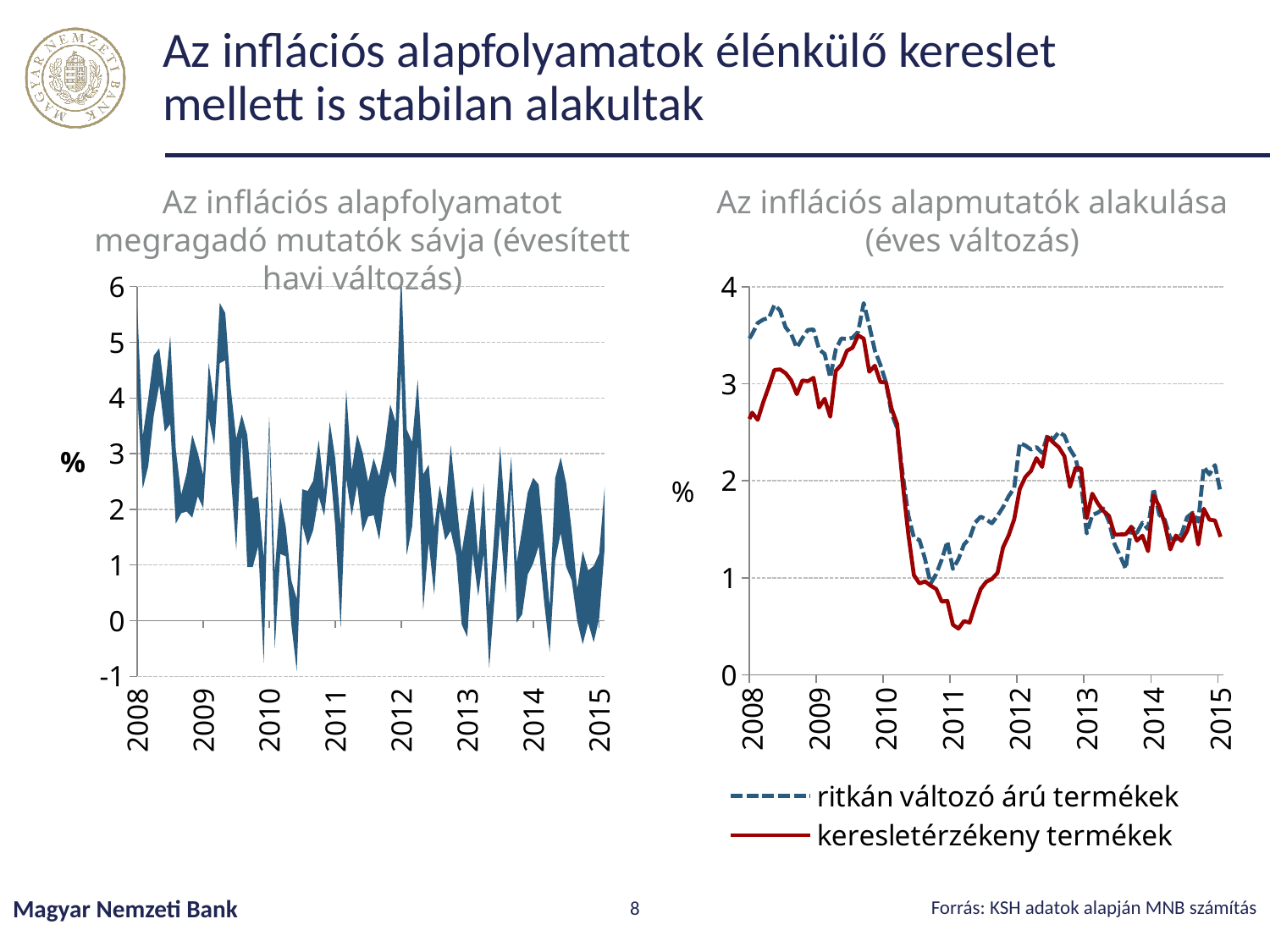
On the left chart, what is the lowest value shown on the y axis? -1 On the right chart, is the value for 'ritkán változó árú termékek' at the start of 2008 greater or less than 3? greater On the left chart, how many year labels are shown on the x axis? 8 On the right chart, which series is higher at the start of 2011, 'ritkán változó árú termékek' or 'keresletérzékeny termékek'? ritkán változó árú termékek On the right chart, is the value for 'keresletérzékeny termékek' at the start of 2011 greater or less than 1? less On the left chart 'Az inflációs alapfolyamatot megragadó mutatók sávja (évesített havi változás)', is the peak of the band around 2012 greater or less than 5? greater On the right chart, which series is drawn with a dashed line? ritkán változó árú termékek On the left chart, does the band overall rise or fall from 2008 to 2015? fall On the right chart, what is the highest value shown on the y axis? 4 On the right chart, do the values of 'keresletérzékeny termékek' overall rise or fall from 2008 to 2015? fall What kind of chart is the right chart 'Az inflációs alapmutatók alakulása (éves változás)'? line chart On the right chart 'Az inflációs alapmutatók alakulása (éves változás)', how many series does the legend list? 2